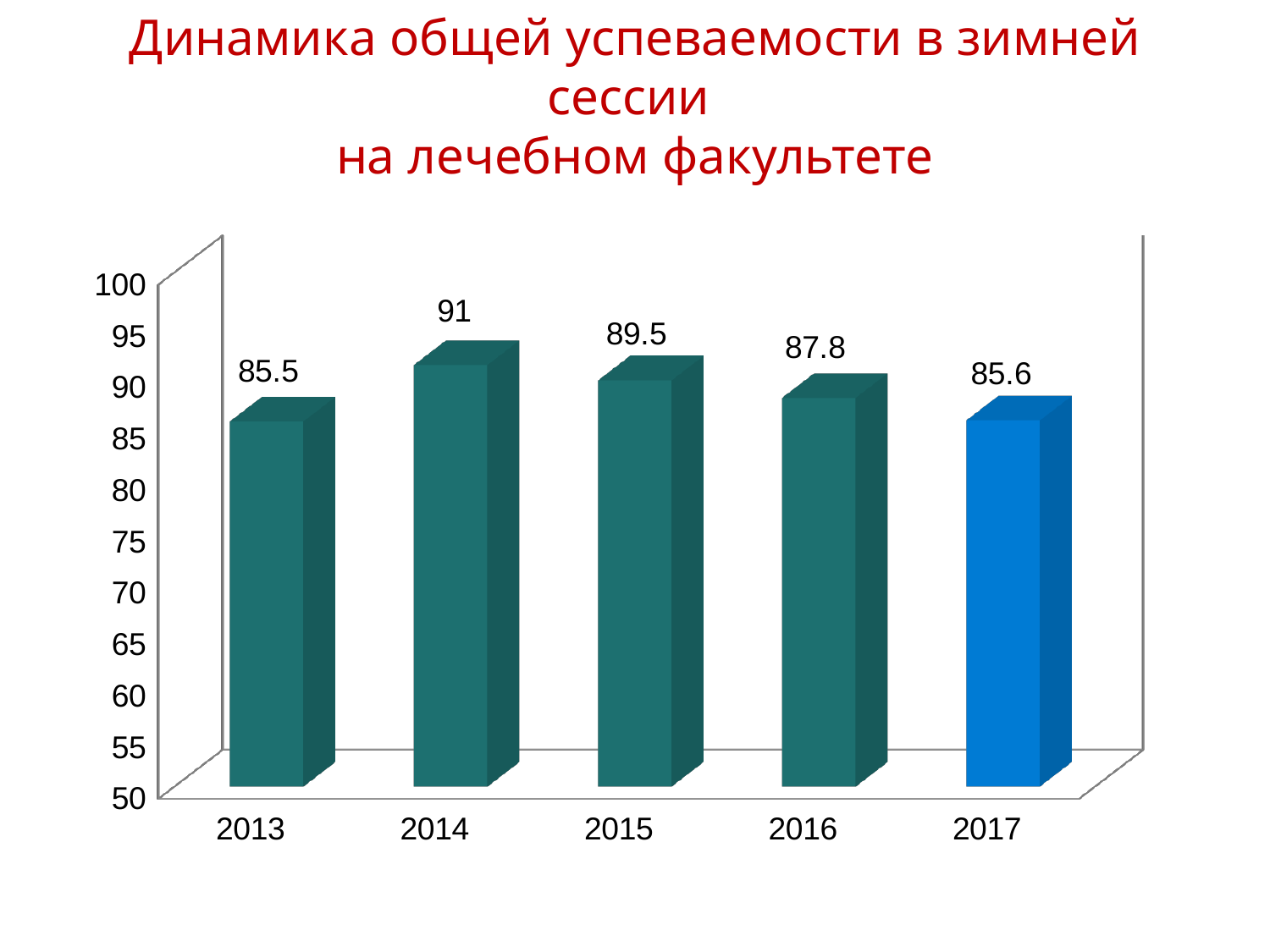
Which year has the lowest value? 2013 What is the value for 2017? 85.6 Do the values rise or fall from 2014 to 2017? fall Which is larger, the value for 2015 or the value for 2017? 2015 What is the value for 2016? 87.8 What is the difference between the values for 2014 and 2013? 5.5 How many years are shown on the x axis? 5 What is the difference between the values for 2015 and 2016? 1.7 Is the value for 2014 greater or less than 90? greater What is the value for 2014? 91 What kind of chart is shown on the slide? bar chart Which year has the highest value? 2014